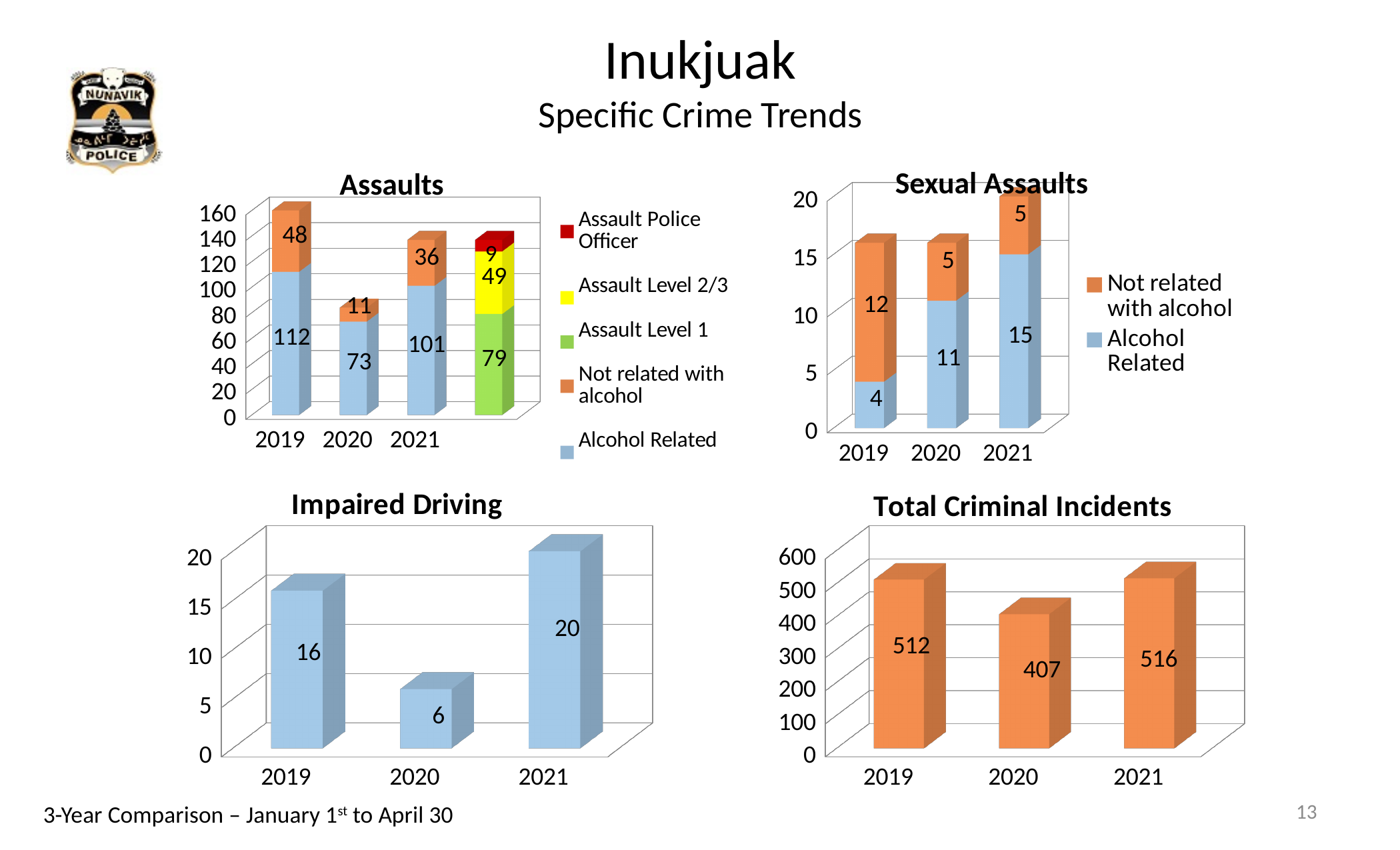
How many series does the legend of the Assaults chart list? 5 What kind of chart is the Impaired Driving chart? bar chart In the Assaults chart, what is the value for Assault Level 1? 79 In the Total Criminal Incidents chart, which year has the highest value? 2021 In the Sexual Assaults chart, what is the Alcohol Related value for 2019? 4 In the Total Criminal Incidents chart, what is the difference between the 2019 and 2020 values? 105 In the Assaults chart, what is the total of the stacked bar for 2020? 84 In the Sexual Assaults chart for 2019, which is larger: Not related with alcohol or Alcohol Related? Not related with alcohol In the Assaults chart, what is the Alcohol Related value for 2019? 112 In the Impaired Driving chart, which year has the lowest value? 2020 In the Sexual Assaults chart, what is the total of the stacked bar for 2021? 20 In the Impaired Driving chart, what is the value for 2020? 6